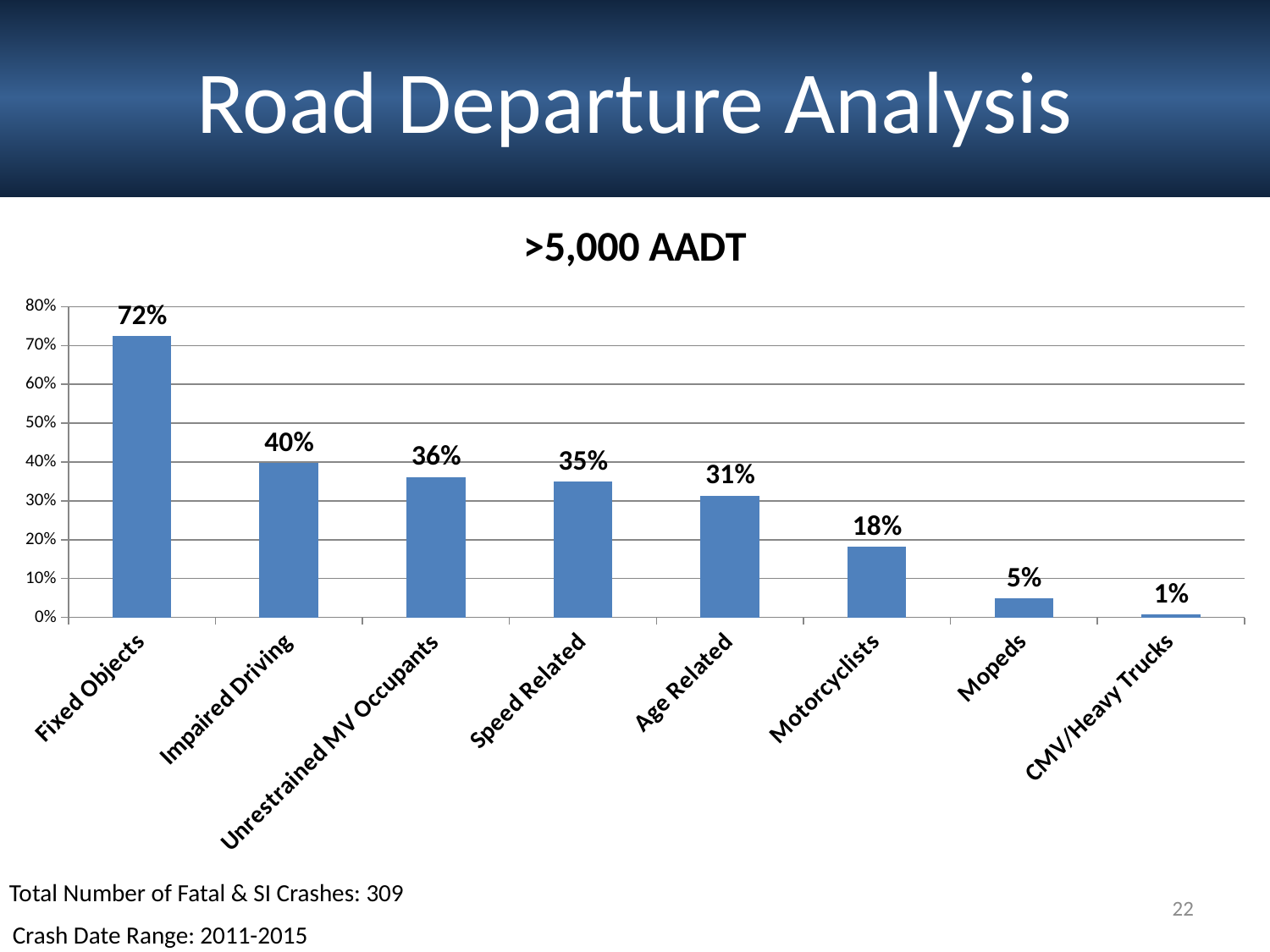
What kind of chart is shown on the slide? Bar chart Which category has the highest value? Fixed Objects What is the value for Motorcyclists? 18% Which is larger, the value for Speed Related or the value for Motorcyclists? Speed Related Which category has the lowest value? CMV/Heavy Trucks Do the values rise or fall from left to right along the x axis? Fall What is the value for Fixed Objects? 72% What is the difference between the values for Fixed Objects and Impaired Driving? 32% What is the difference between the values for Age Related and Motorcyclists? 13% What is the value for Mopeds? 5% What is the title of the chart? >5,000 AADT How many categories are shown on the chart? 8